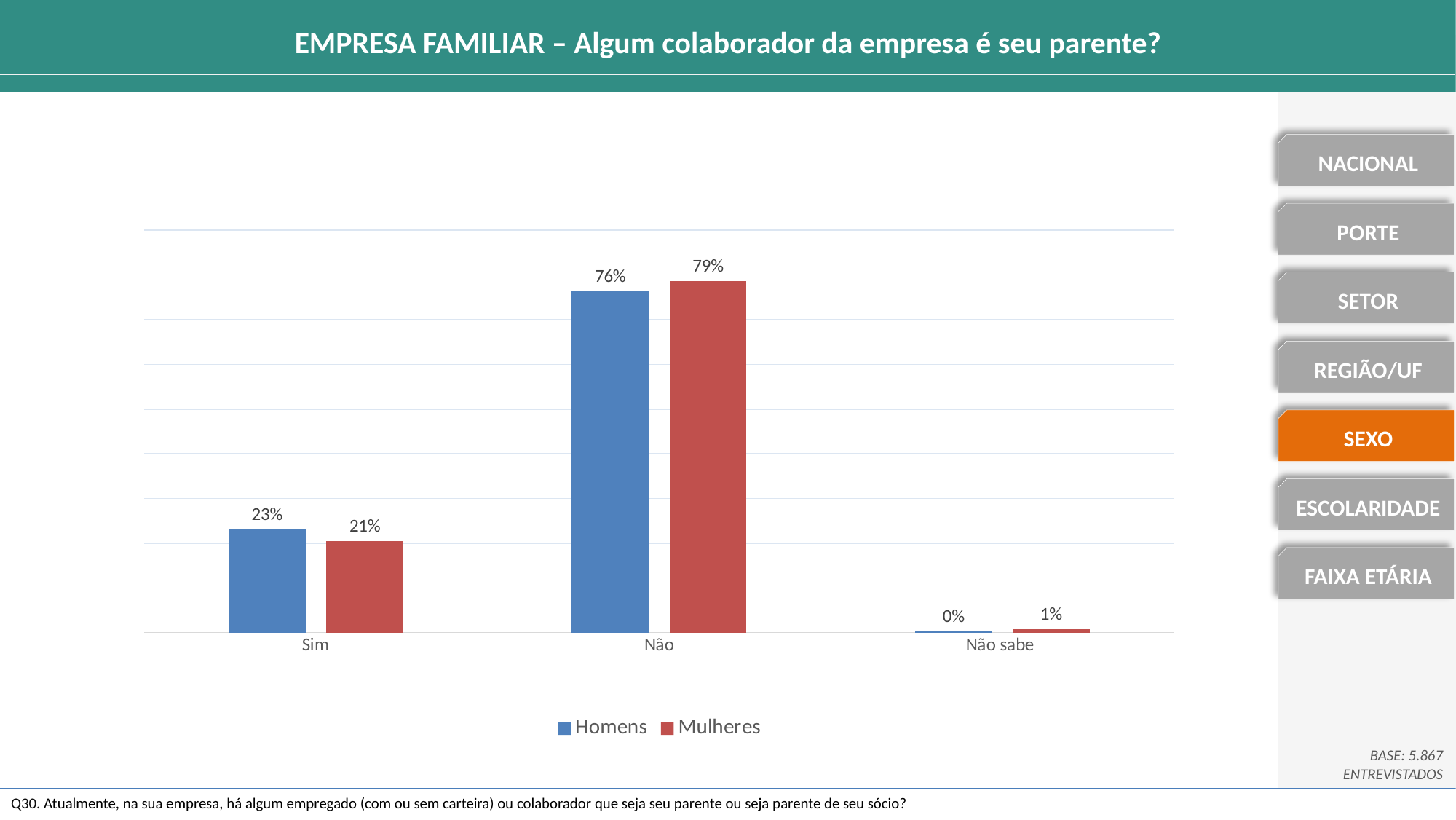
How many categories are shown on the x axis? 3 What is the value for Mulheres in the Não category? 79% Which category has the highest value for Homens? Não What kind of chart is shown on the slide? Bar chart What is the value for Mulheres in the Não sabe category? 1% Which series is shown in red in the legend? Mulheres What is the difference between Homens and Mulheres in the Sim category? 2% What is the difference between Mulheres and Homens in the Não category? 3% In the Sim category, which series has the larger value, Homens or Mulheres? Homens Which category has the lowest value for Mulheres? Não sabe What is the value for Homens in the Sim category? 23% How many series does the legend list? 2